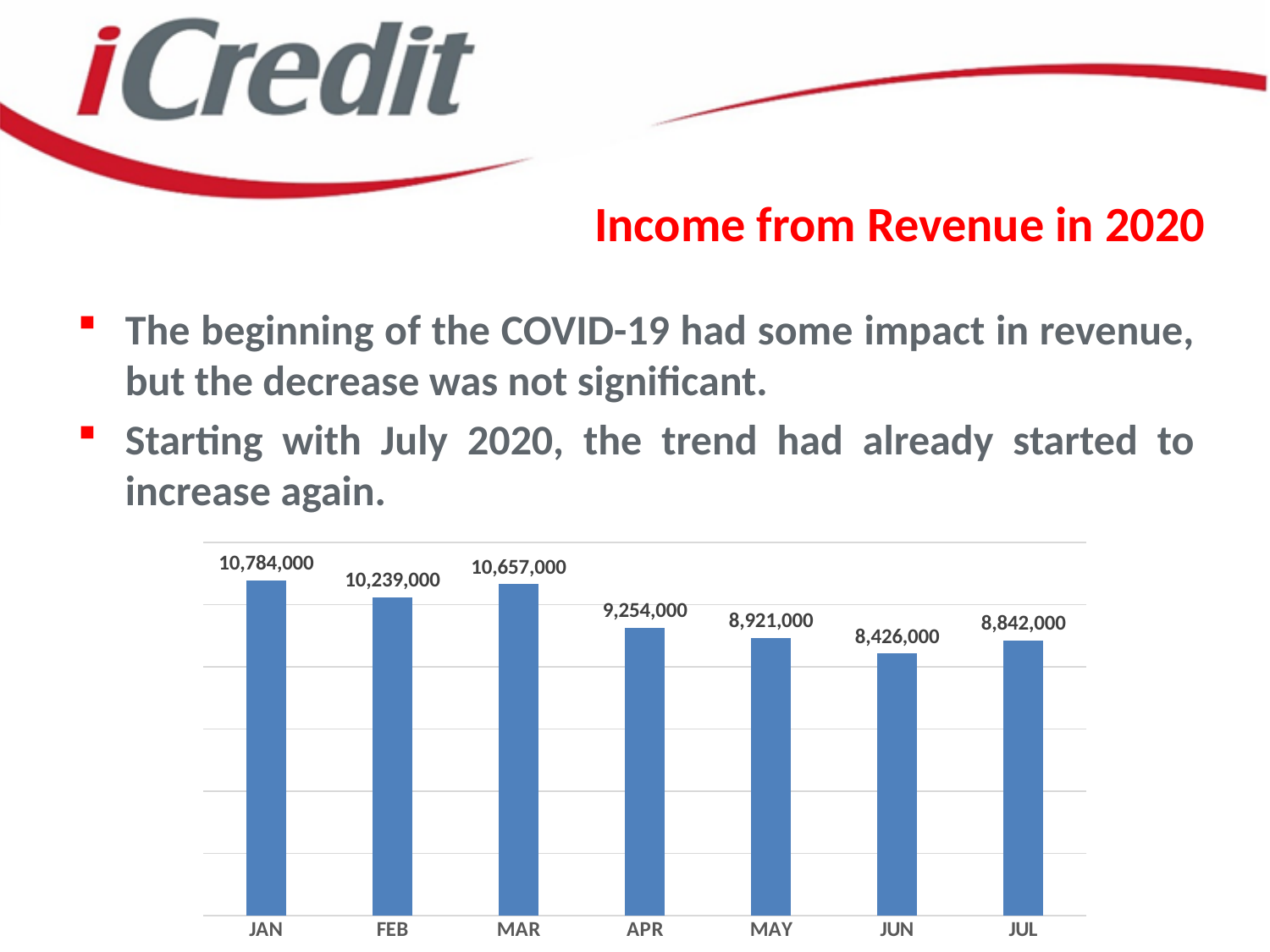
What kind of chart is shown on the slide? bar chart What is the value for JUN? 8,426,000 Which month has the lowest value? JUN How many months are shown on the chart? 7 What is the value for JUL? 8,842,000 What is the value for JAN? 10,784,000 What is the difference between the values for JUL and JUN? 416,000 Which month has the highest value? JAN Which is larger, the value for FEB or the value for MAR? MAR What is the difference between the values for JAN and JUL? 1,942,000 What is the value for APR? 9,254,000 Do the values generally rise or fall from JAN to JUN? fall